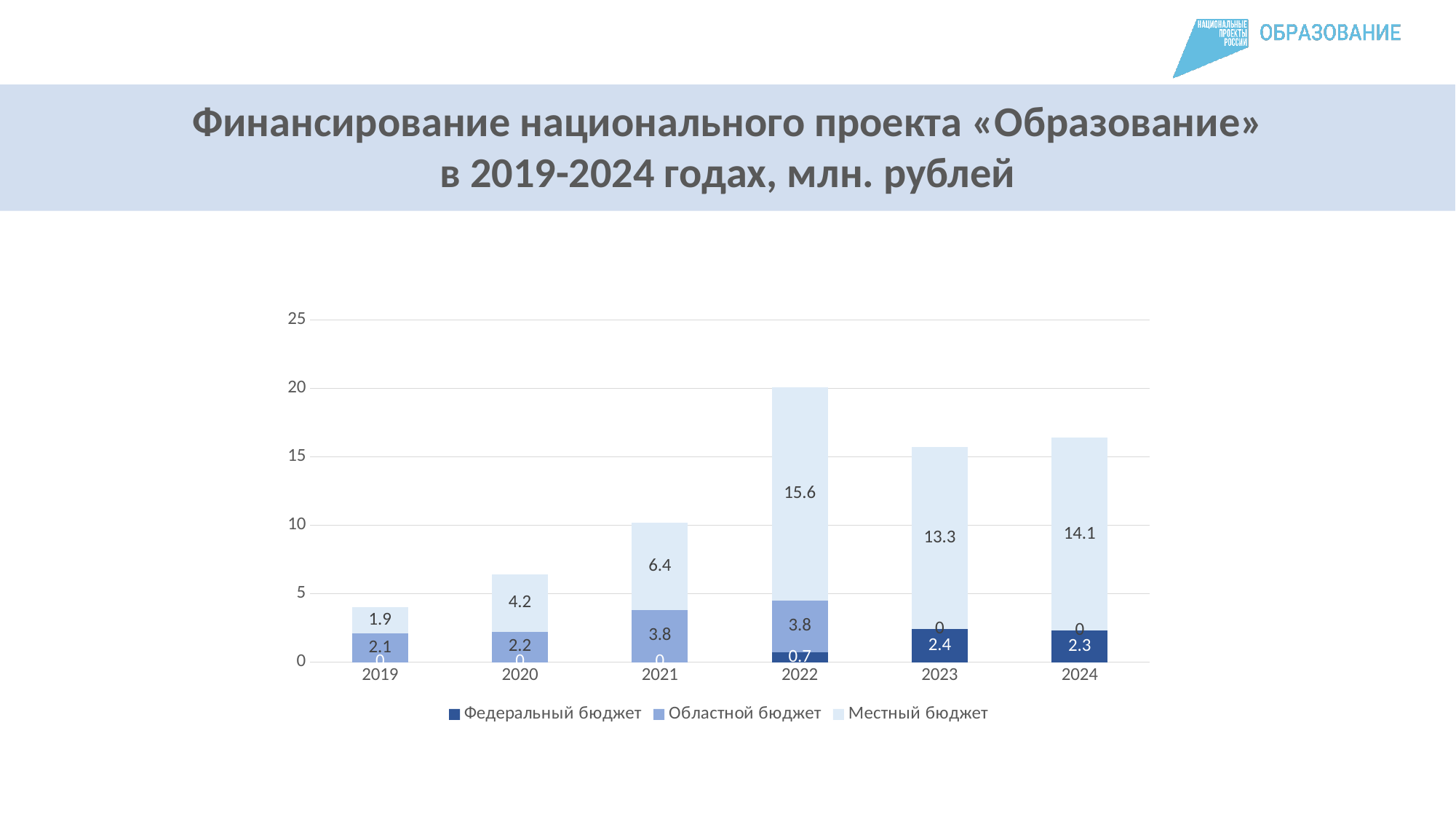
What is the value of Федеральный бюджет in 2023? 2.4 What is the difference between the Местный бюджет values in 2024 and 2023? 0.8 How many series does the legend list? 3 What type of chart is shown on the slide? Stacked bar chart Which is larger: Областной бюджет in 2020 or Областной бюджет in 2021? 2021 What is the value of Местный бюджет in 2022? 15.6 What is the total of the stacked bar for 2022? 20.1 What is the value of Областной бюджет in 2021? 3.8 In which year is the Местный бюджет value the highest? 2022 How many years are shown on the x axis? 6 Which series is shown in the darkest blue colour? Федеральный бюджет In which year is the Местный бюджет value the lowest? 2019